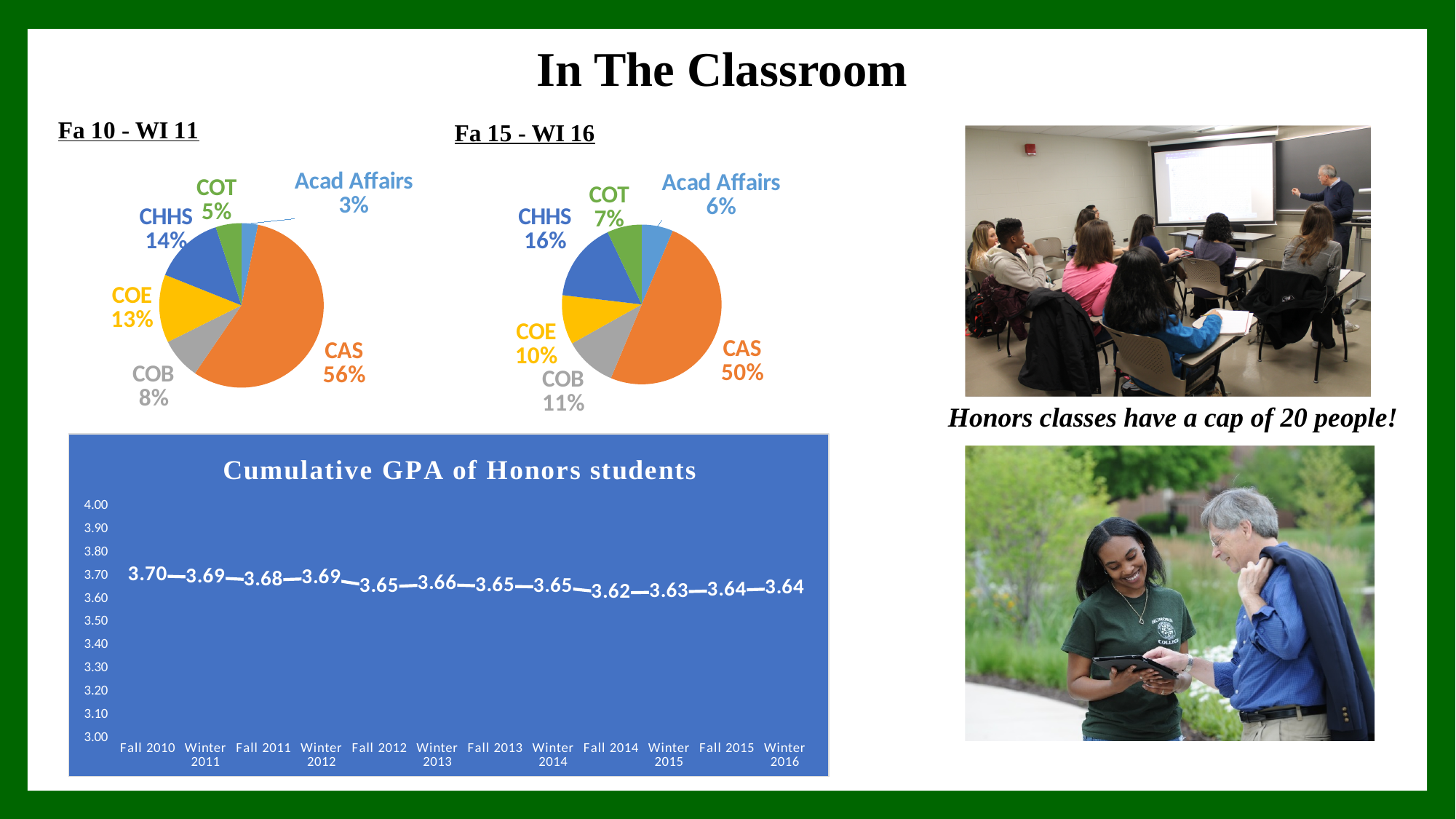
In the Fa 15 - WI 16 pie chart, what share does CHHS have? 16% In the Cumulative GPA of Honors students chart, what is the difference between Fall 2010 and Winter 2016? 0.06 In the Fa 10 - WI 11 pie chart, which is larger, COE or COB? COE How many categories are shown in the Fa 15 - WI 16 pie chart? 6 In the Fa 10 - WI 11 pie chart, which category has the smallest slice? Acad Affairs In the Cumulative GPA of Honors students chart, which term has the lowest value? Fall 2014 In the Cumulative GPA of Honors students chart, what is the value for Fall 2010? 3.70 In the Fa 15 - WI 16 pie chart, what is the difference between the COB and COE shares? 1% In the Fa 15 - WI 16 pie chart, which category has the largest slice? CAS In the Fa 10 - WI 11 pie chart, what share does CAS have? 56% How many data points are plotted in the Cumulative GPA of Honors students chart? 12 What kind of chart is the Cumulative GPA of Honors students chart? Line chart